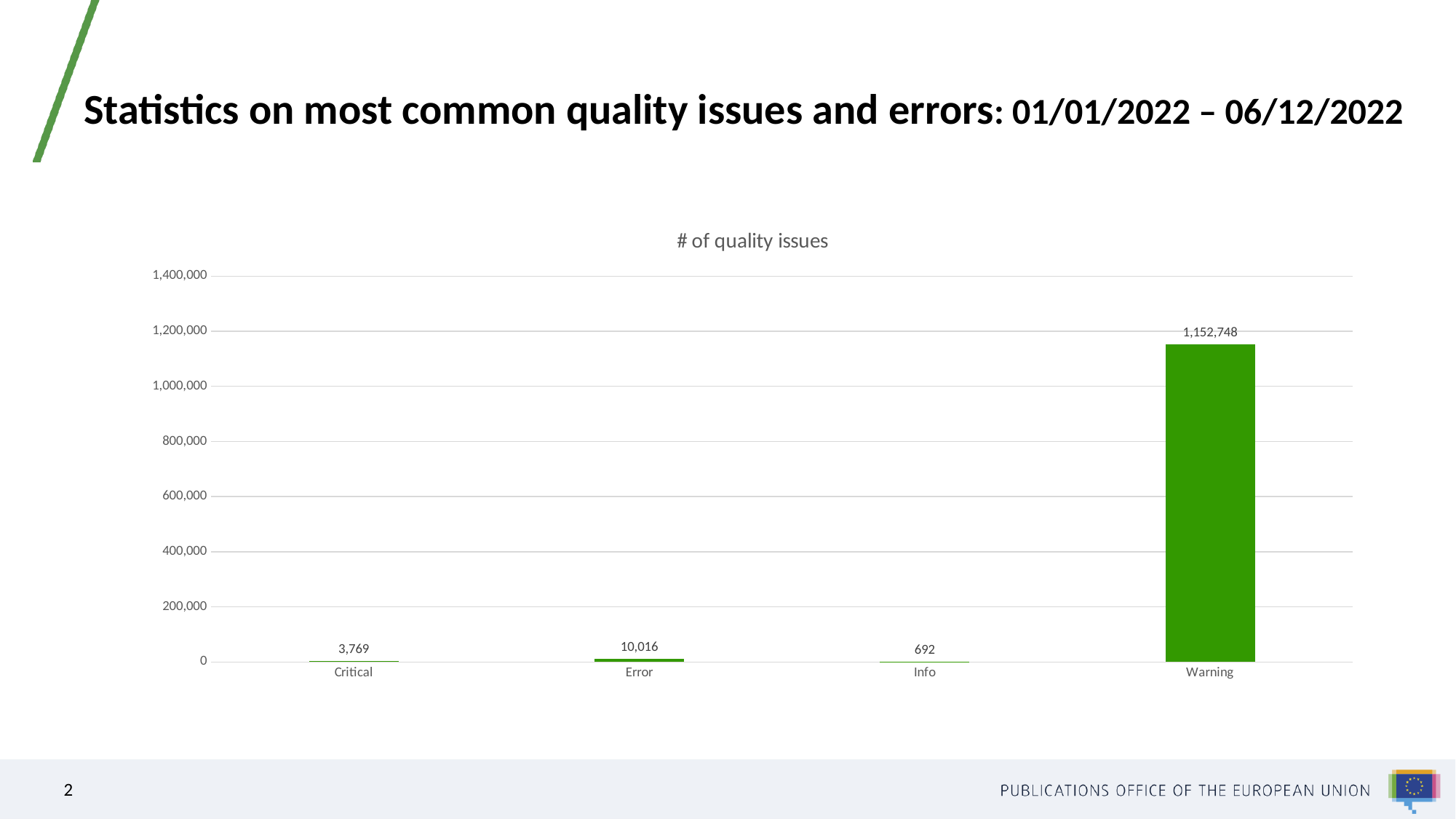
What is the value for Info? 692 Which category has the lowest number of quality issues? Info Which category has the highest number of quality issues? Warning How many categories are shown on the x axis? 4 What kind of chart is shown on the slide? bar chart What is the value for Warning? 1,152,748 What is the title of the chart? # of quality issues What is the value for Error? 10,016 What is the difference between the values for Error and Critical? 6,247 What is the value for Critical? 3,769 Is the value for Warning greater or less than 1,000,000? greater Which is larger, the value for Critical or the value for Info? Critical